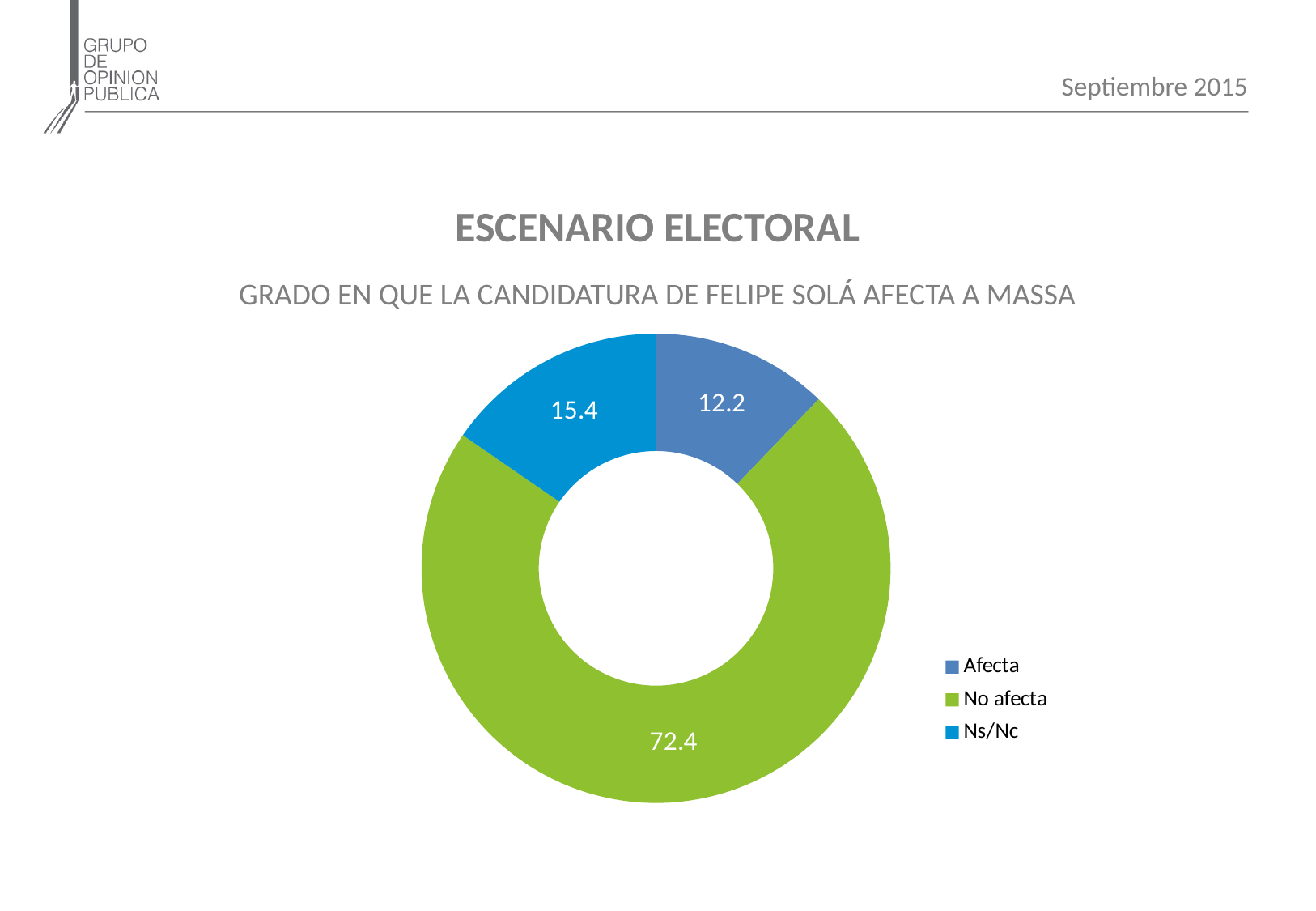
How many categories does the chart show? 3 What is the difference between the values for "Ns/Nc" and "Afecta"? 3.2 Which category has the lowest value? Afecta Which category has the highest value? No afecta What is the difference between the values for "No afecta" and "Ns/Nc"? 57 What is the value for "Ns/Nc"? 15.4 What is the value for "Afecta"? 12.2 What is the title of the chart? GRADO EN QUE LA CANDIDATURA DE FELIPE SOLÁ AFECTA A MASSA What kind of chart is shown on the slide? Doughnut chart What colour is the "No afecta" segment? Green What is the value for "No afecta"? 72.4 Which is larger, the value for "Ns/Nc" or the value for "Afecta"? Ns/Nc